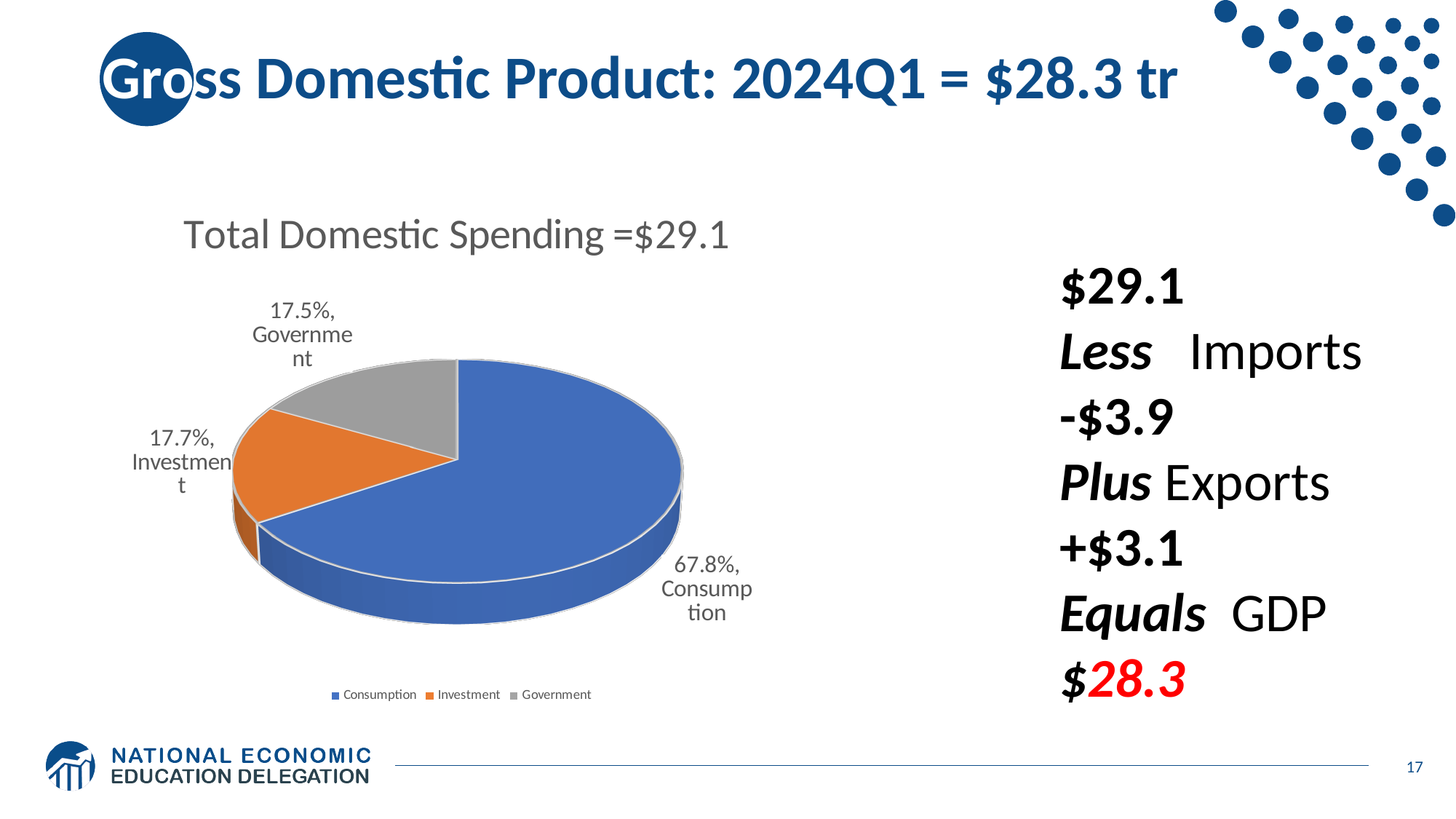
What share of the pie does Consumption represent? 67.8% How many categories are shown in the pie chart? 3 How many entries does the legend list? 3 Which category has the smallest slice of the pie? Government What kind of chart is shown on the slide? Pie chart What is the difference in percentage points between the Consumption and Investment slices? 50.1 What share of the pie does Government represent? 17.5% What is the difference in percentage points between the Investment and Government slices? 0.2 Which colour represents Investment in the pie chart? Orange Which category has the largest slice of the pie? Consumption What share of the pie does Investment represent? 17.7% What is the title of the chart? Total Domestic Spending =$29.1